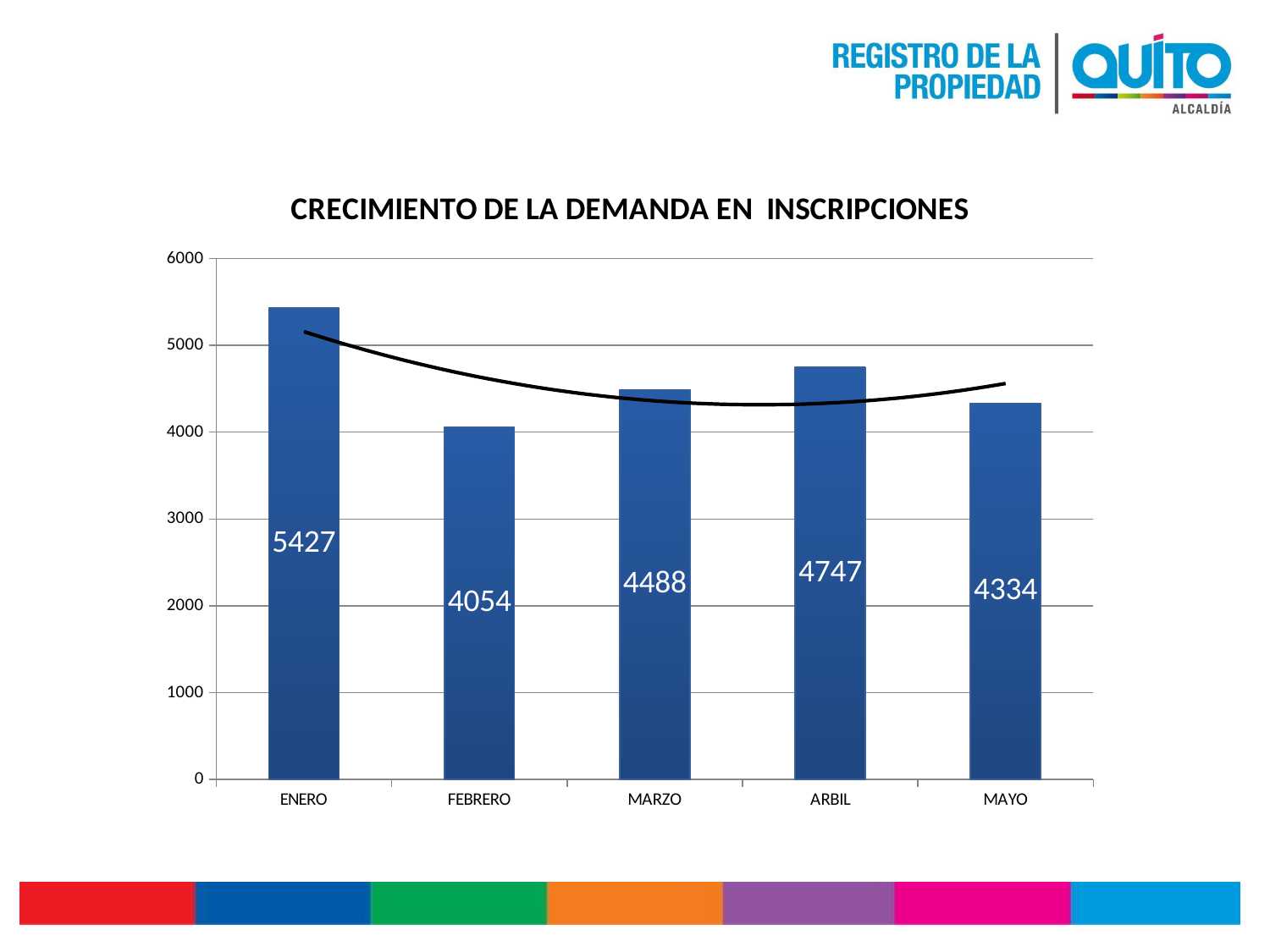
What is the value for FEBRERO? 4054 What is the value for MARZO? 4488 What kind of chart is shown on the slide? Bar chart What is the title of the chart? CRECIMIENTO DE LA DEMANDA EN INSCRIPCIONES What is the value for MAYO? 4334 How many months are shown on the x axis? 5 Which is larger, the value for MARZO or the value for MAYO? MARZO Which month has the highest value? ENERO What is the value for ARBIL? 4747 Which month has the lowest value? FEBRERO What is the value for ENERO? 5427 What is the difference between the values for ENERO and FEBRERO? 1373